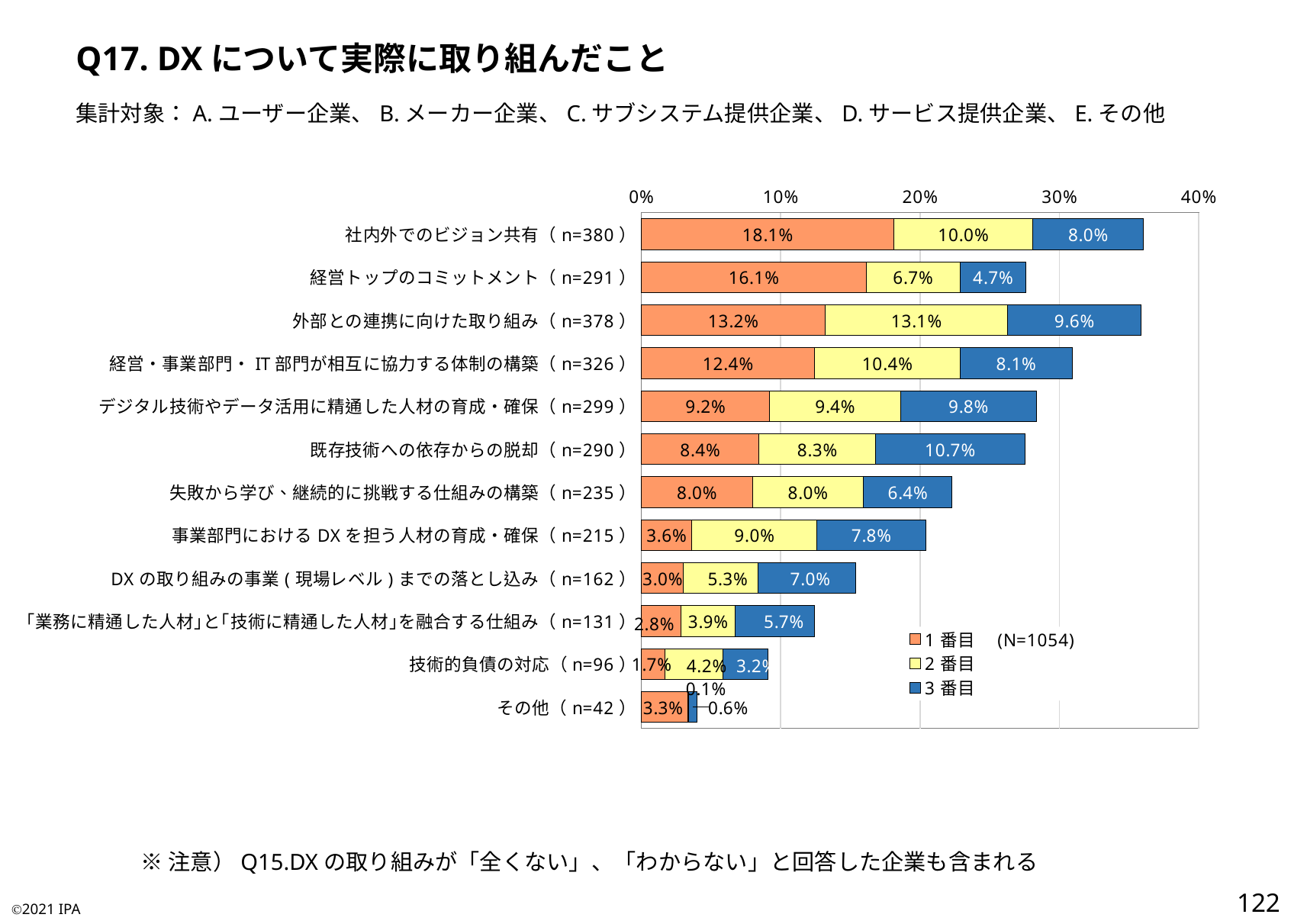
Which is larger: the 3番目 value for デジタル技術やデータ活用に精通した人材の育成・確保 (n=299) or the 3番目 value for 失敗から学び、継続的に挑戦する仕組みの構築 (n=235)? デジタル技術やデータ活用に精通した人材の育成・確保 (n=299) How many series does the legend list? 3 What is the 2番目 value for 外部との連携に向けた取り組み (n=378)? 13.1% What is the difference between the 1番目 values for 社内外でのビジョン共有 (n=380) and 経営トップのコミットメント (n=291)? 2.0% What is the 1番目 value for 社内外でのビジョン共有 (n=380)? 18.1% Which category has the highest 1番目 value? 社内外でのビジョン共有 (n=380) Which category has the lowest 1番目 value? 技術的負債の対応 (n=96) What total N is shown next to the legend? N=1054 What kind of chart is shown on the slide? Stacked bar chart What is the 3番目 value for 既存技術への依存からの脱却 (n=290)? 10.7% How many categories are plotted in the chart? 12 What is the total of the stacked bar for 経営トップのコミットメント (n=291)? 27.5%